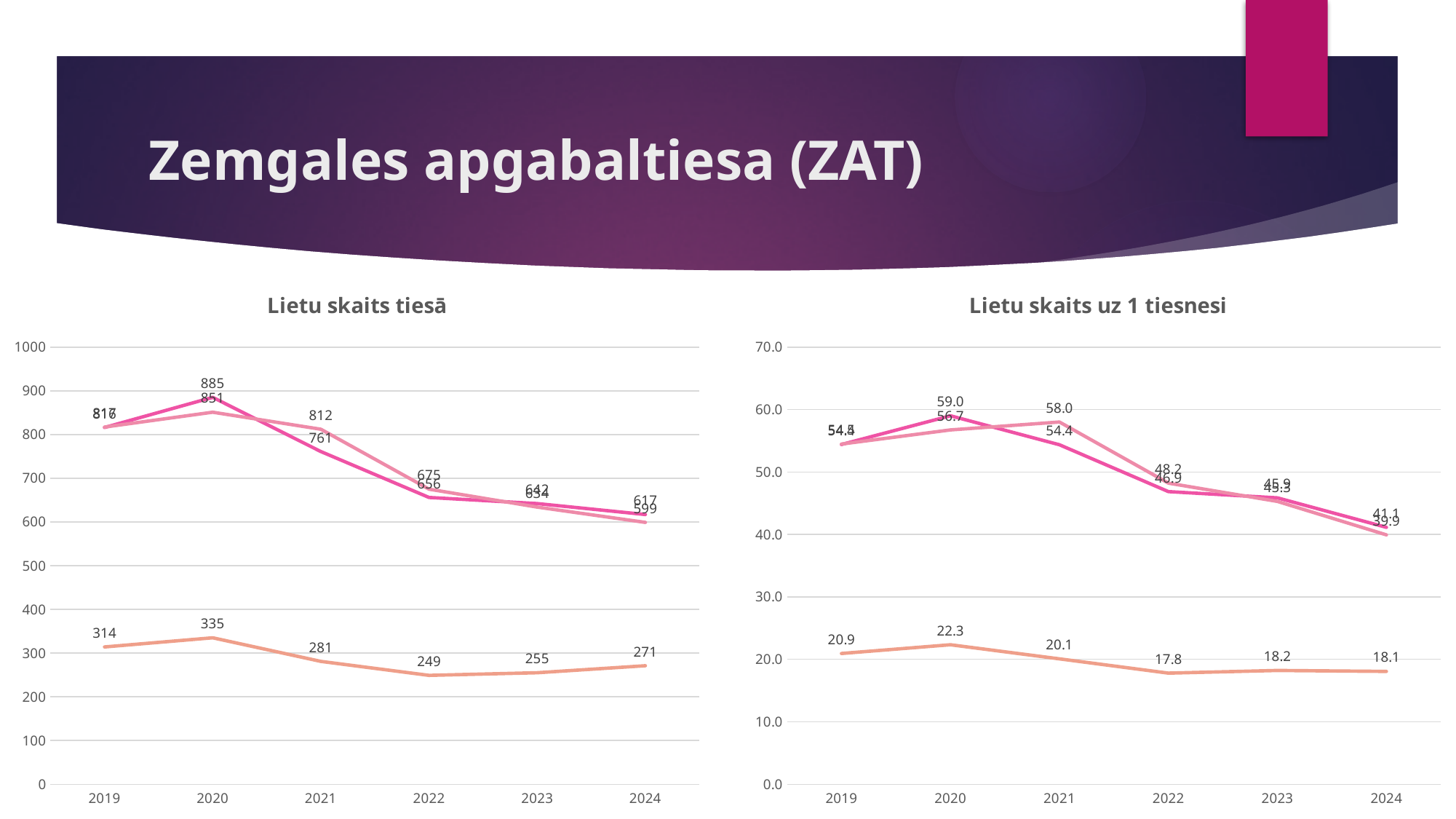
In the 'Lietu skaits uz 1 tiesnesi' chart, what is the value of the orange (lowest) line in 2020? 22.3 In the 'Lietu skaits tiesā' chart, what is the difference between the orange line's 2020 value and its 2022 value? 86 In the 'Lietu skaits tiesā' chart, in which year does the orange (lowest) line reach its highest value? 2020 In the 'Lietu skaits uz 1 tiesnesi' chart, do the two upper (pink) lines rise or fall between 2021 and 2024? fall In the 'Lietu skaits tiesā' chart, is the highest value plotted in 2020 greater or less than 800? greater In the 'Lietu skaits tiesā' chart, how many years are shown on the x axis? 6 In the 'Lietu skaits uz 1 tiesnesi' chart, what is the value of the orange (lowest) line in 2022? 17.8 What kind of chart is the 'Lietu skaits tiesā' chart? line chart In the 'Lietu skaits tiesā' chart, what is the value of the orange (lowest) line in 2019? 314 In the 'Lietu skaits tiesā' chart, in which year does the orange (lowest) line reach its lowest value? 2022 What is the title of the chart on the right side of the slide? Lietu skaits uz 1 tiesnesi In the 'Lietu skaits uz 1 tiesnesi' chart, is the orange line's value in 2019 larger or smaller than its value in 2024? larger